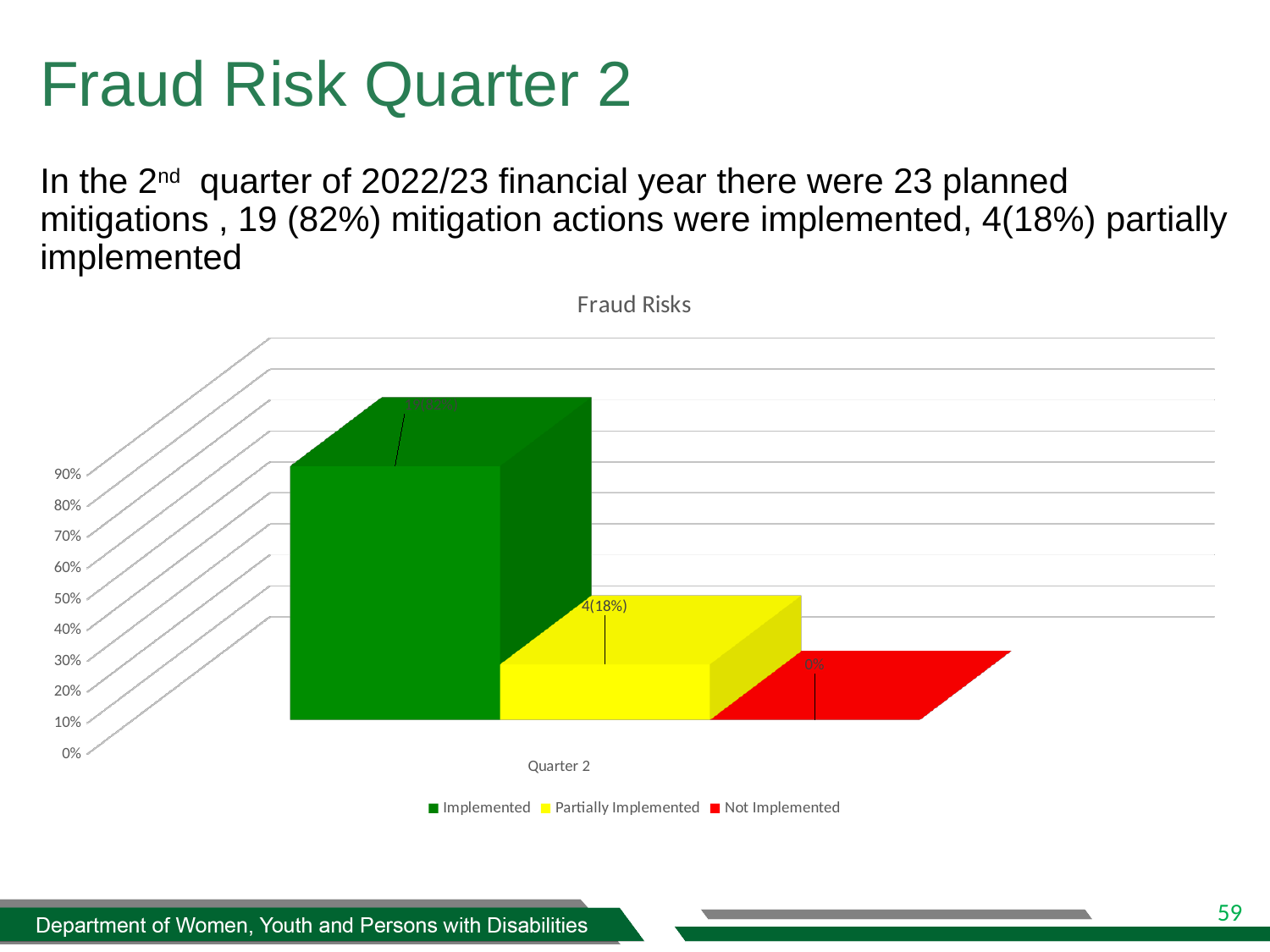
What is the title of the chart? Fraud Risks Which colour represents Not Implemented in the legend? red What is the data label for Partially Implemented in Quarter 2? 4(18%) What kind of chart is shown on the slide? bar chart Which series has the lowest value in Quarter 2? Not Implemented How many series does the chart legend list? 3 Which series has the highest value in Quarter 2? Implemented What is the data label for Not Implemented in Quarter 2? 0% Which is larger in Quarter 2, Implemented or Partially Implemented? Implemented Is the value for Implemented greater or less than 50%? greater How many categories are shown on the x axis of the chart? 1 What is the data label for Implemented in Quarter 2? 19(82%)